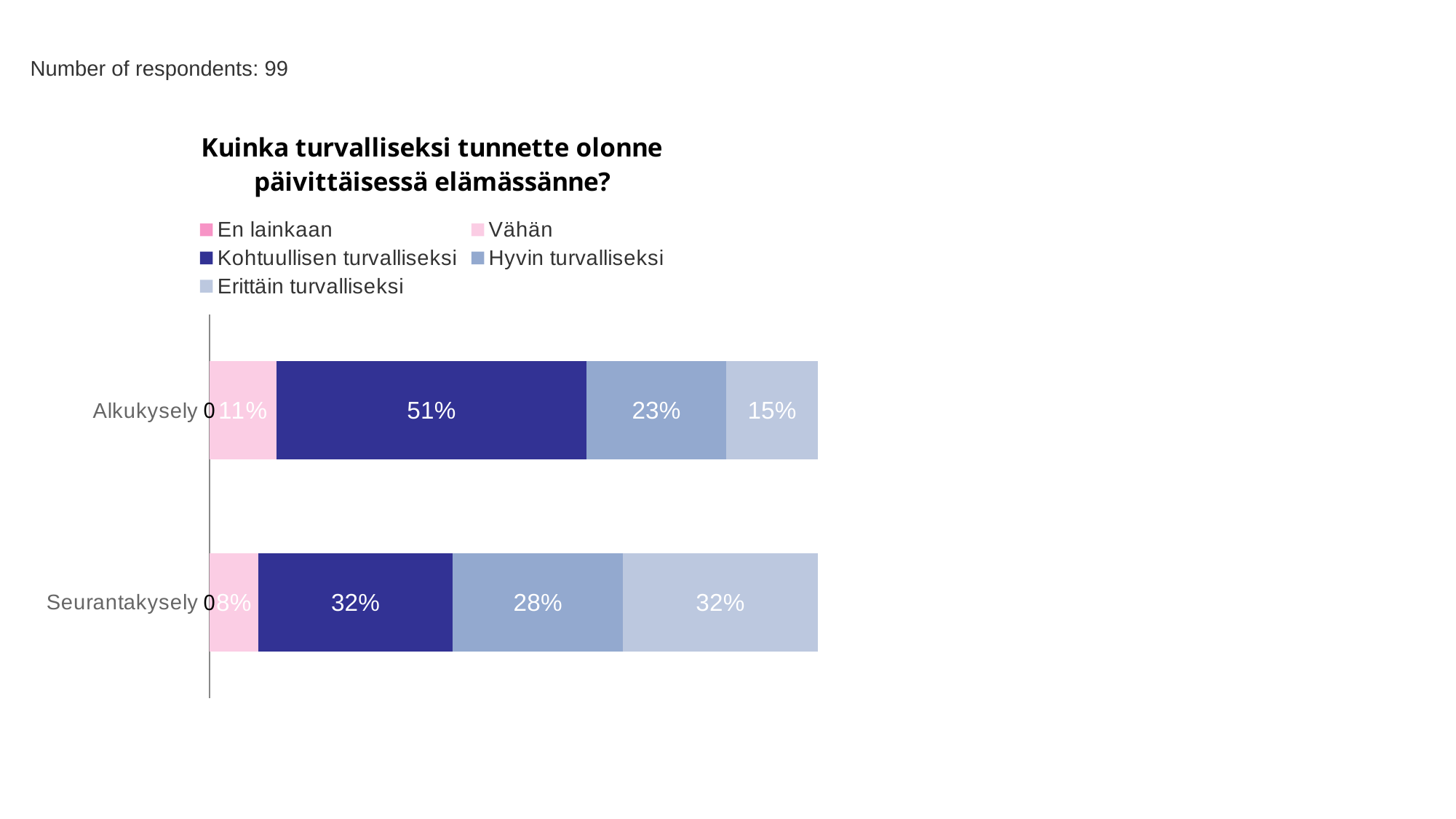
What is the value for Hyvin turvalliseksi in Seurantakysely? 28% What is the difference between the Kohtuullisen turvalliseksi values for Alkukysely and Seurantakysely? 19% How many categories are plotted on the chart? 2 What is the value for Erittäin turvalliseksi in Seurantakysely? 32% Which segment is the largest in the Alkukysely bar? Kohtuullisen turvalliseksi How many series does the legend list? 5 Which is larger: Erittäin turvalliseksi in Alkukysely or in Seurantakysely? Seurantakysely What is the number of respondents stated on the slide? 99 What is the value for Kohtuullisen turvalliseksi in Alkukysely? 51% What is the value for Vähän in Alkukysely? 11% What is the value for En lainkaan in Alkukysely? 0 What kind of chart is shown on the slide? stacked bar chart